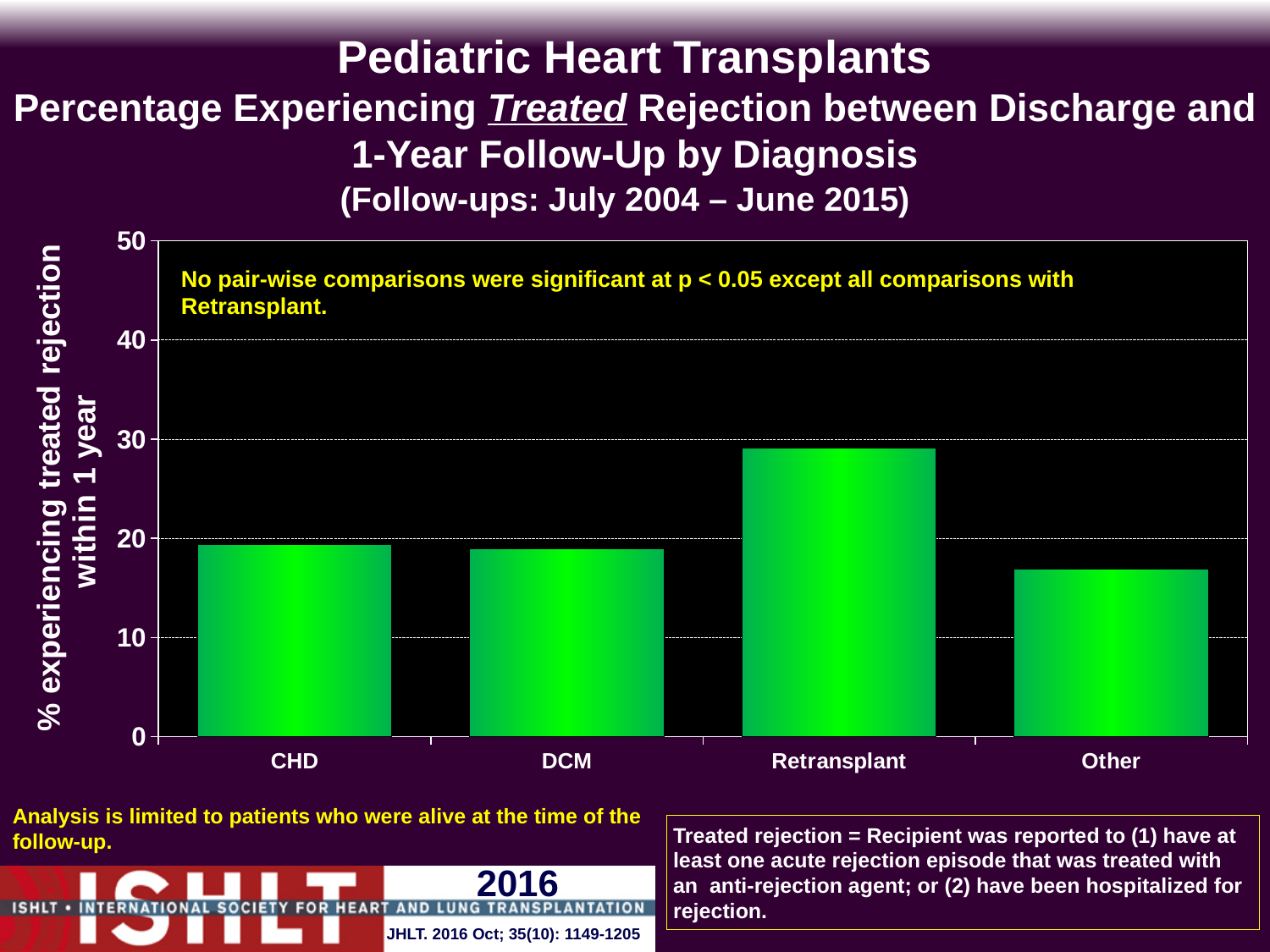
Is the value for CHD greater or less than 20? less Which diagnosis category has the lowest percentage experiencing treated rejection within 1 year? Other Is the value for Retransplant greater or less than 20? greater Which diagnosis category has the highest percentage experiencing treated rejection within 1 year? Retransplant Is the value for Retransplant greater or less than 30? less Which is larger, the value for Retransplant or the value for CHD? Retransplant Which is larger, the value for DCM or the value for Other? DCM How many diagnosis categories are shown on the x axis? 4 What is the label on the y axis of the chart? % experiencing treated rejection within 1 year What kind of chart is shown on the slide? bar chart